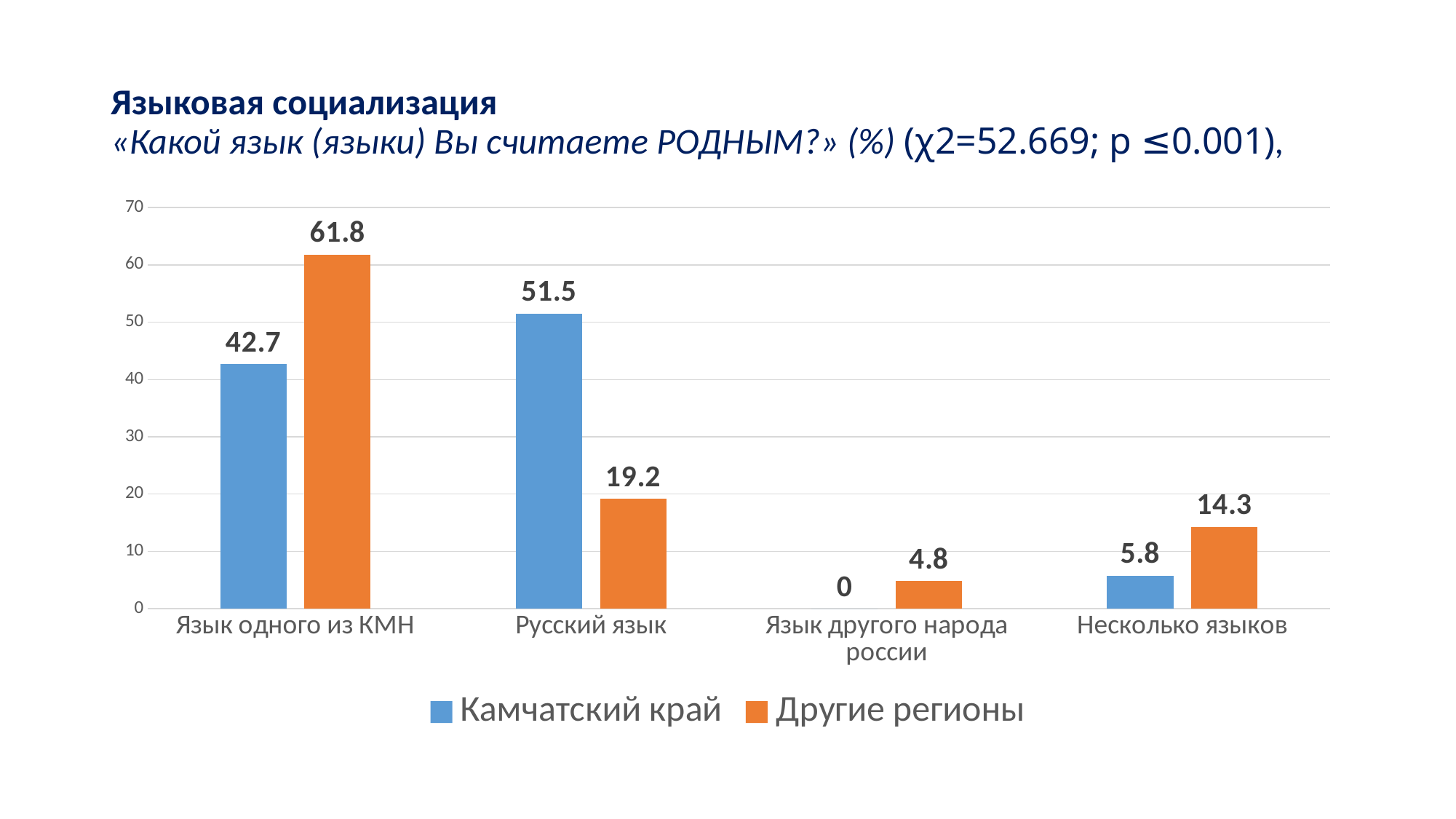
Which is larger in the category Русский язык: Камчатский край or Другие регионы? Камчатский край How many categories are shown on the x axis? 4 Which colour represents the series Другие регионы in the legend? Orange Which category has the lowest value for Камчатский край? Язык другого народа россии What is the value for Камчатский край in the category Язык одного из КМН? 42.7 How many series does the legend list? 2 What is the value for Камчатский край in the category Язык другого народа россии? 0 Which category has the highest value for Другие регионы? Язык одного из КМН What is the value for Другие регионы in the category Русский язык? 19.2 What kind of chart is shown on the slide? Bar chart What is the difference between Другие регионы and Камчатский край in the category Язык одного из КМН? 19.1 What is the value for Другие регионы in the category Несколько языков? 14.3